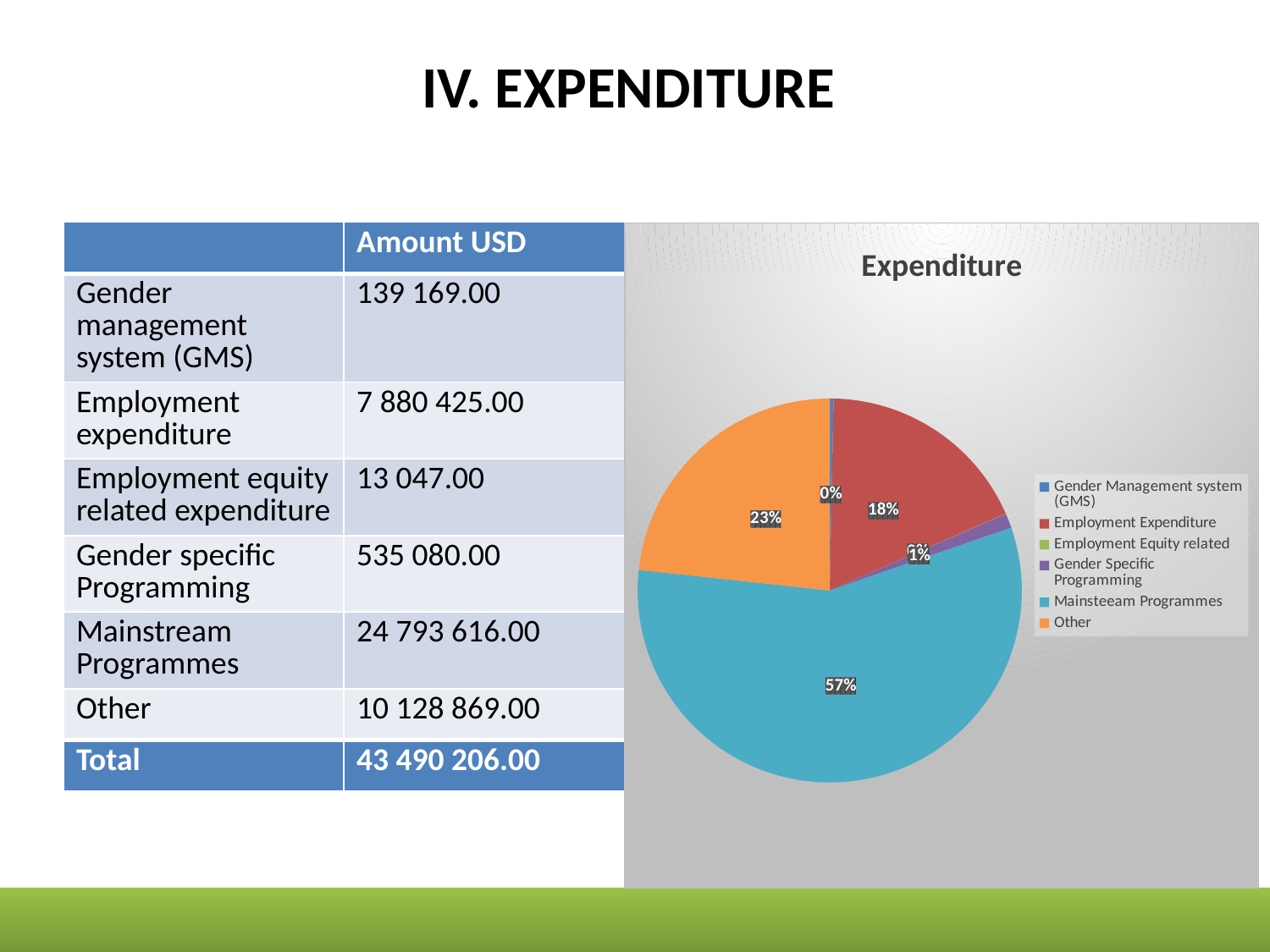
What colour is the Mainsteeam Programmes slice? teal/blue What share of the pie is labelled for Other? 23% What is the difference in percentage points between the Mainsteeam Programmes slice and the Other slice? 34 What is the title of the chart? Expenditure Which slice is larger, Other or Employment Expenditure? Other How many entries does the chart's legend list? 6 What type of chart is shown on the slide? pie chart What share of the pie is labelled for Gender Specific Programming? 1% Which category has the largest slice of the pie? Mainsteeam Programmes What share of the pie is labelled for Mainsteeam Programmes? 57%